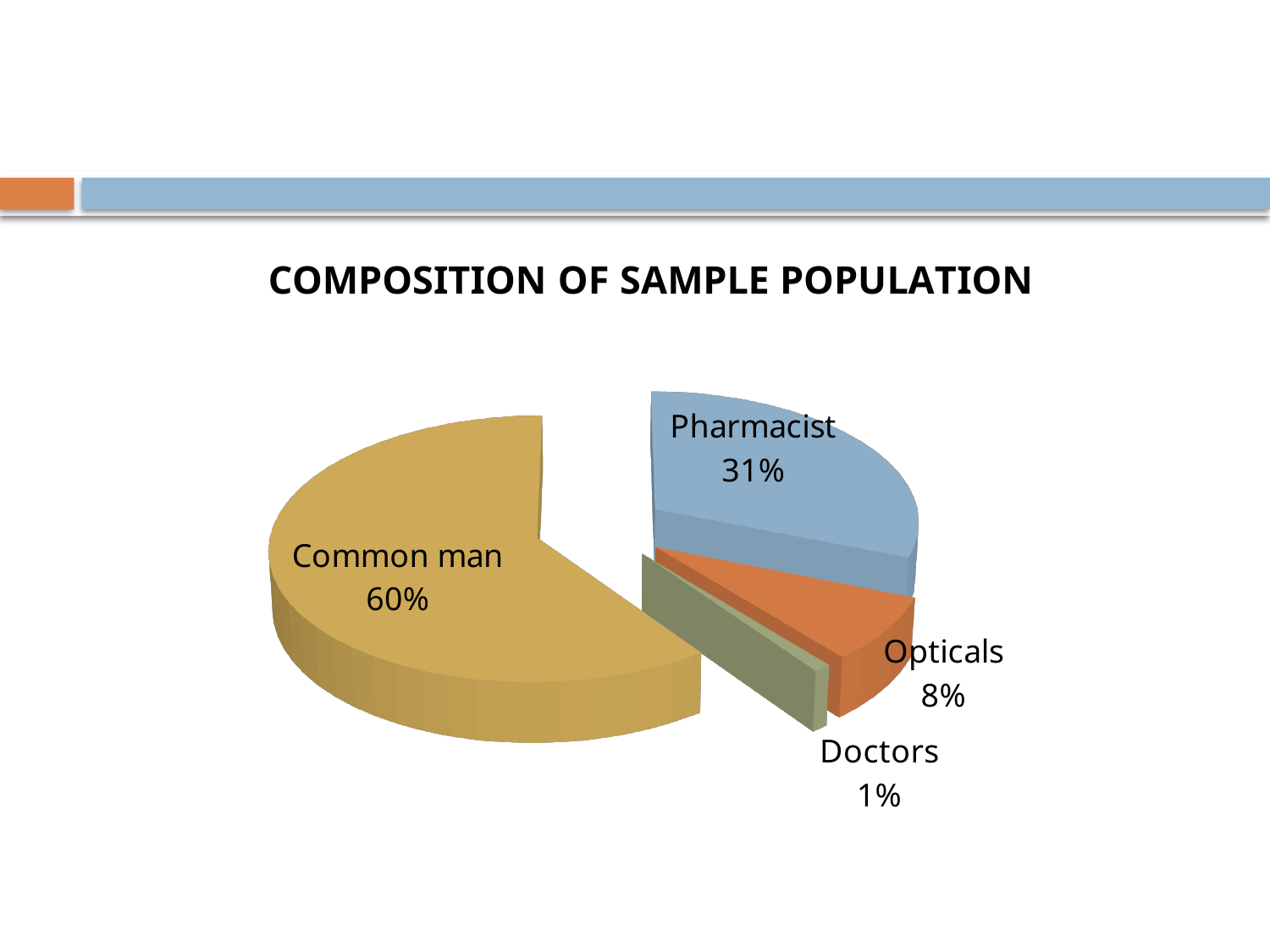
What share of the sample population is Pharmacist? 31% What is the title of the chart? COMPOSITION OF SAMPLE POPULATION Which is larger, the share for Pharmacist or the share for Opticals? Pharmacist What share of the sample population is Common man? 60% Which category has the largest share of the sample population? Common man What is the difference in percentage points between the Common man and Pharmacist shares? 29 Which category has the smallest share of the sample population? Doctors What is the difference in percentage points between the Opticals and Doctors shares? 7 What share of the sample population is Doctors? 1% What kind of chart is shown on the slide? Pie chart What share of the sample population is Opticals? 8% How many categories are shown in the pie chart? 4